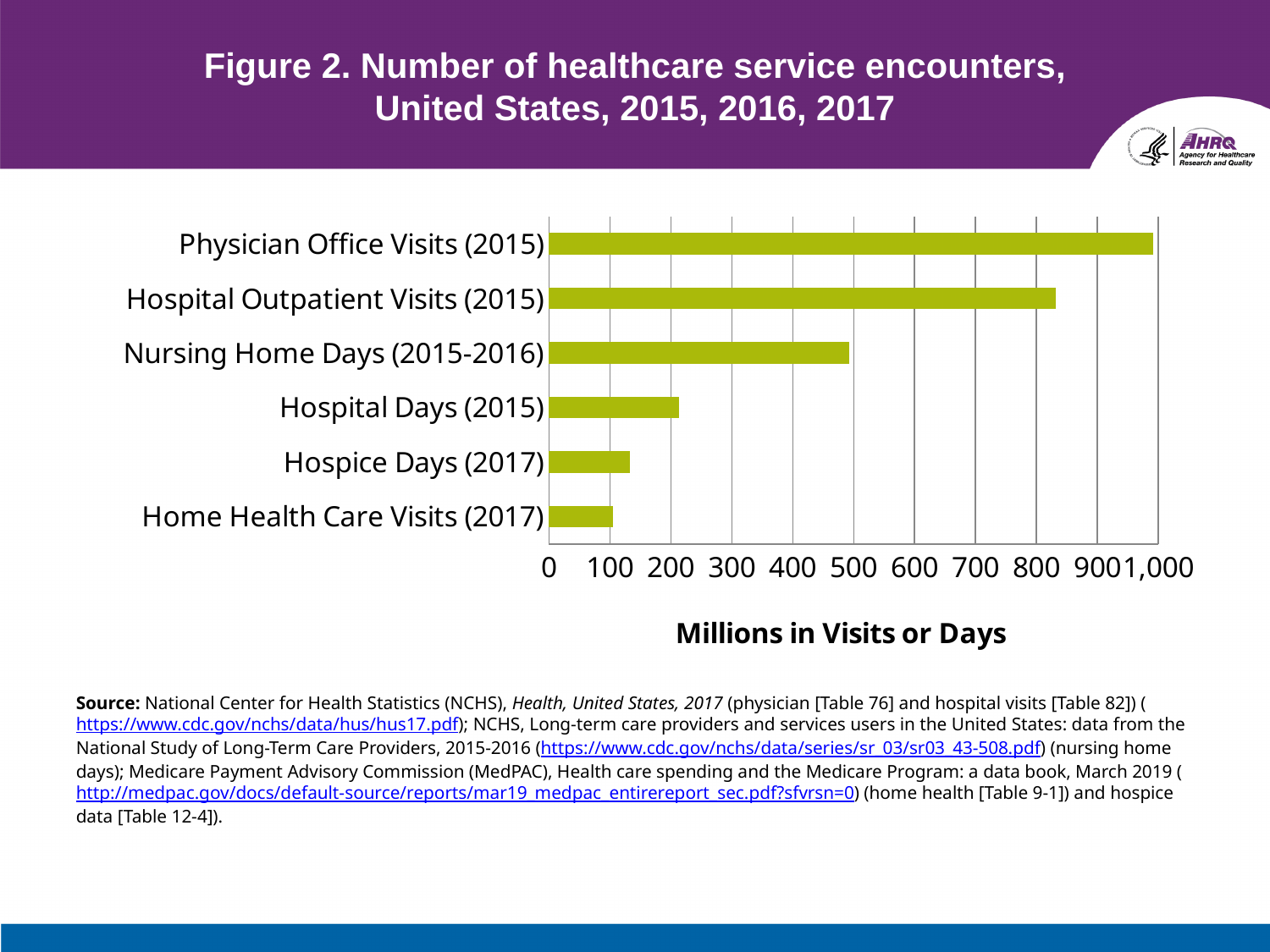
Is the value for Hospital Outpatient Visits (2015) greater or less than 800? greater Is the value for Home Health Care Visits (2017) greater or less than 200? less Is the value for Nursing Home Days (2015-2016) greater or less than 400? greater What is the label on the horizontal axis of the chart? Millions in Visits or Days Which is larger, Hospital Outpatient Visits (2015) or Nursing Home Days (2015-2016)? Hospital Outpatient Visits (2015) How many categories are plotted in the chart? 6 Which category has the highest value? Physician Office Visits (2015) What kind of chart is shown on the slide? bar chart Which category has the lowest value? Home Health Care Visits (2017)